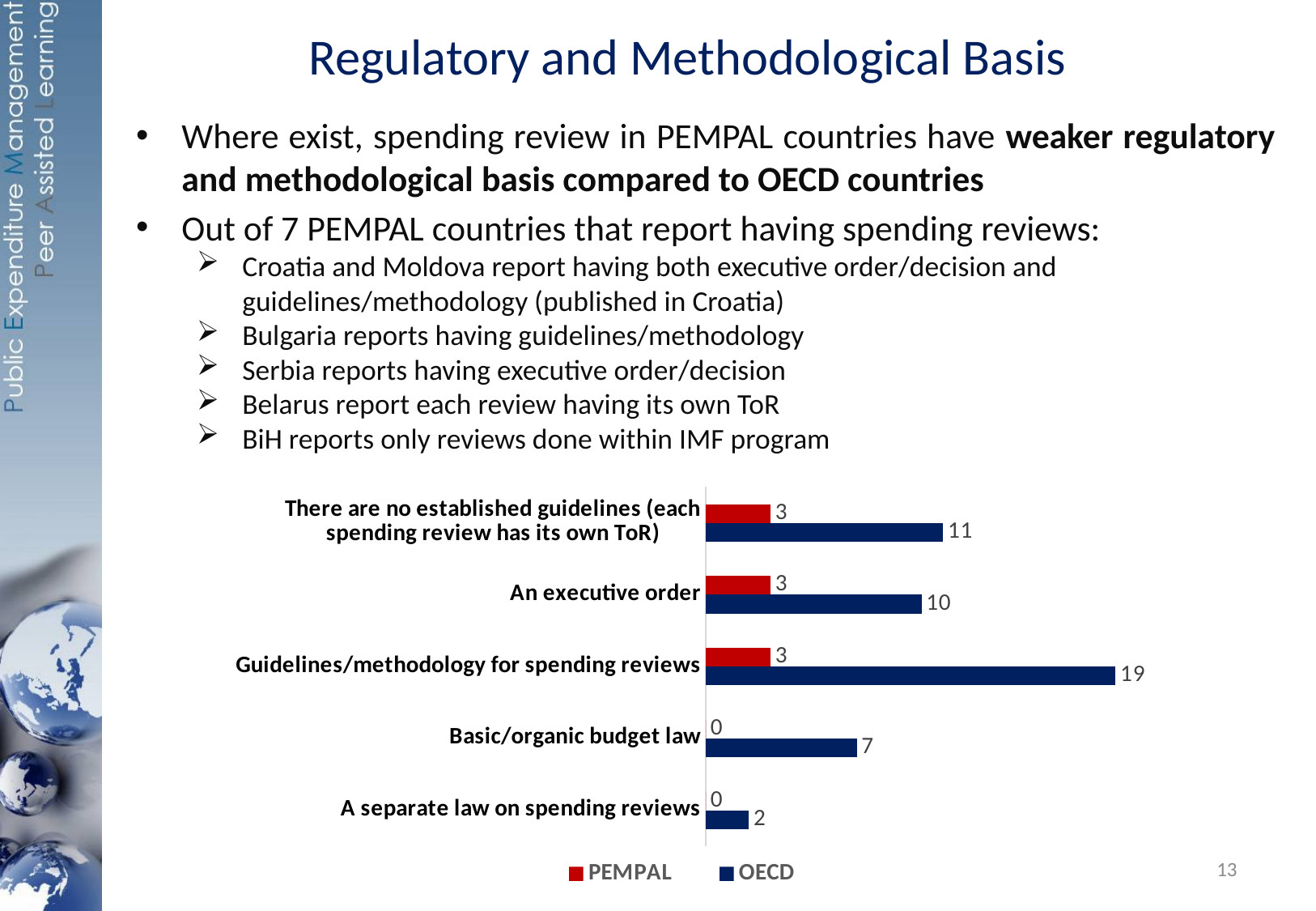
How many series does the legend list? 2 Which is larger: the OECD value for "An executive order" or the OECD value for "Basic/organic budget law"? An executive order Which category has the highest OECD value? Guidelines/methodology for spending reviews Which category has the lowest OECD value? A separate law on spending reviews Which series is shown in red in the chart? PEMPAL What is the difference between the OECD and PEMPAL values for "There are no established guidelines (each spending review has its own ToR)"? 8 What is the OECD value for "Guidelines/methodology for spending reviews"? 19 What is the OECD value for "Basic/organic budget law"? 7 What is the PEMPAL value for "A separate law on spending reviews"? 0 What is the PEMPAL value for "An executive order"? 3 How many categories are shown in the chart? 5 What kind of chart is shown on the slide? Bar chart